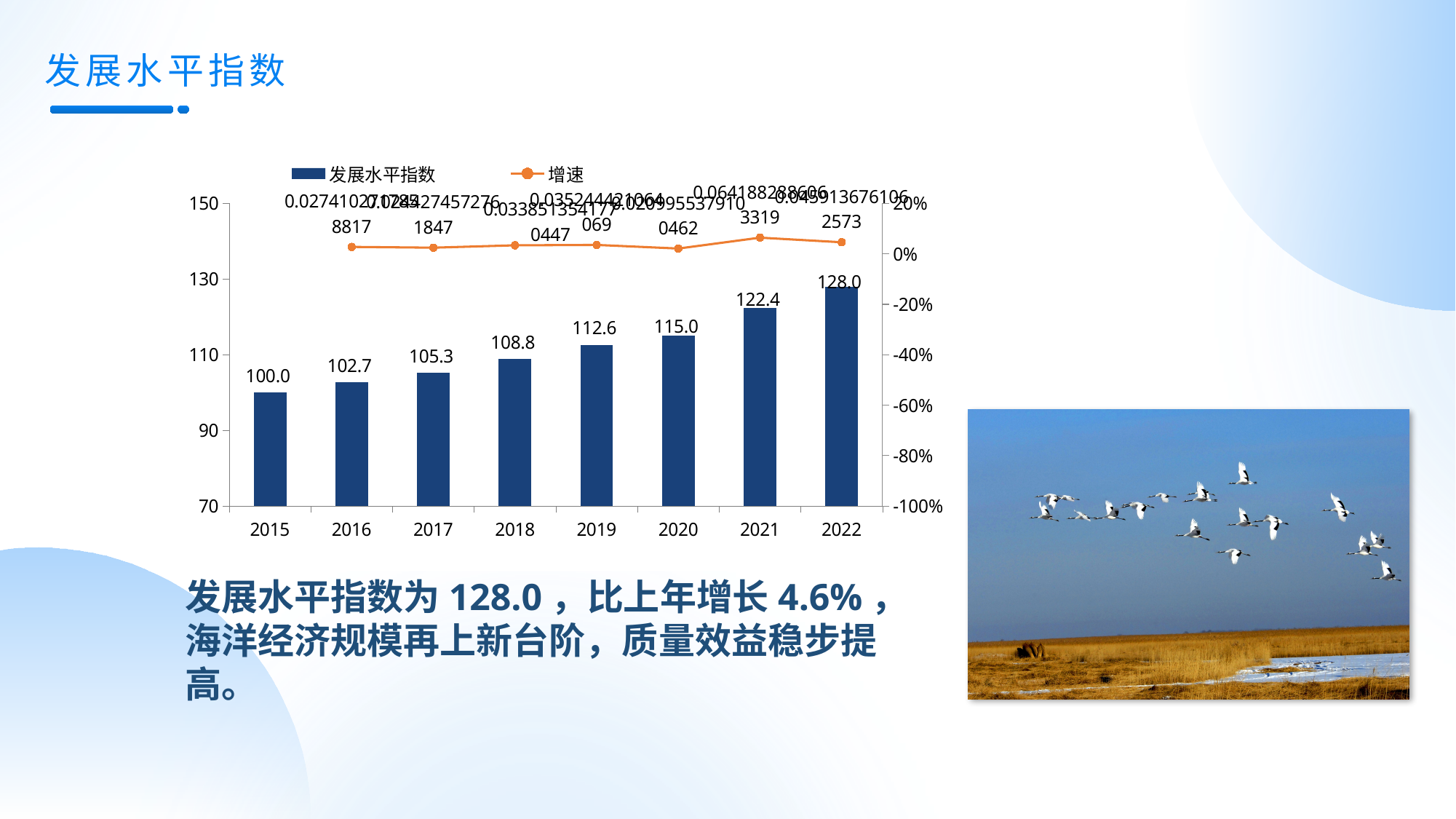
What is the difference between the 发展水平指数 values for 2022 and 2021? 5.6 Which is larger, the 发展水平指数 for 2018 or for 2020? 2020 What is the value of 发展水平指数 for 2019? 112.6 What is the value of 发展水平指数 for 2015? 100.0 Which year has the lowest 发展水平指数? 2015 Which year has the highest 发展水平指数? 2022 How many series does the chart legend list? 2 How many years are shown on the x axis of the chart? 8 Does the 发展水平指数 rise or fall from 2015 to 2022? rise What is the difference between the 发展水平指数 values for 2020 and 2015? 15.0 What is the value of 发展水平指数 for 2022? 128.0 What is the value of 发展水平指数 for 2021? 122.4